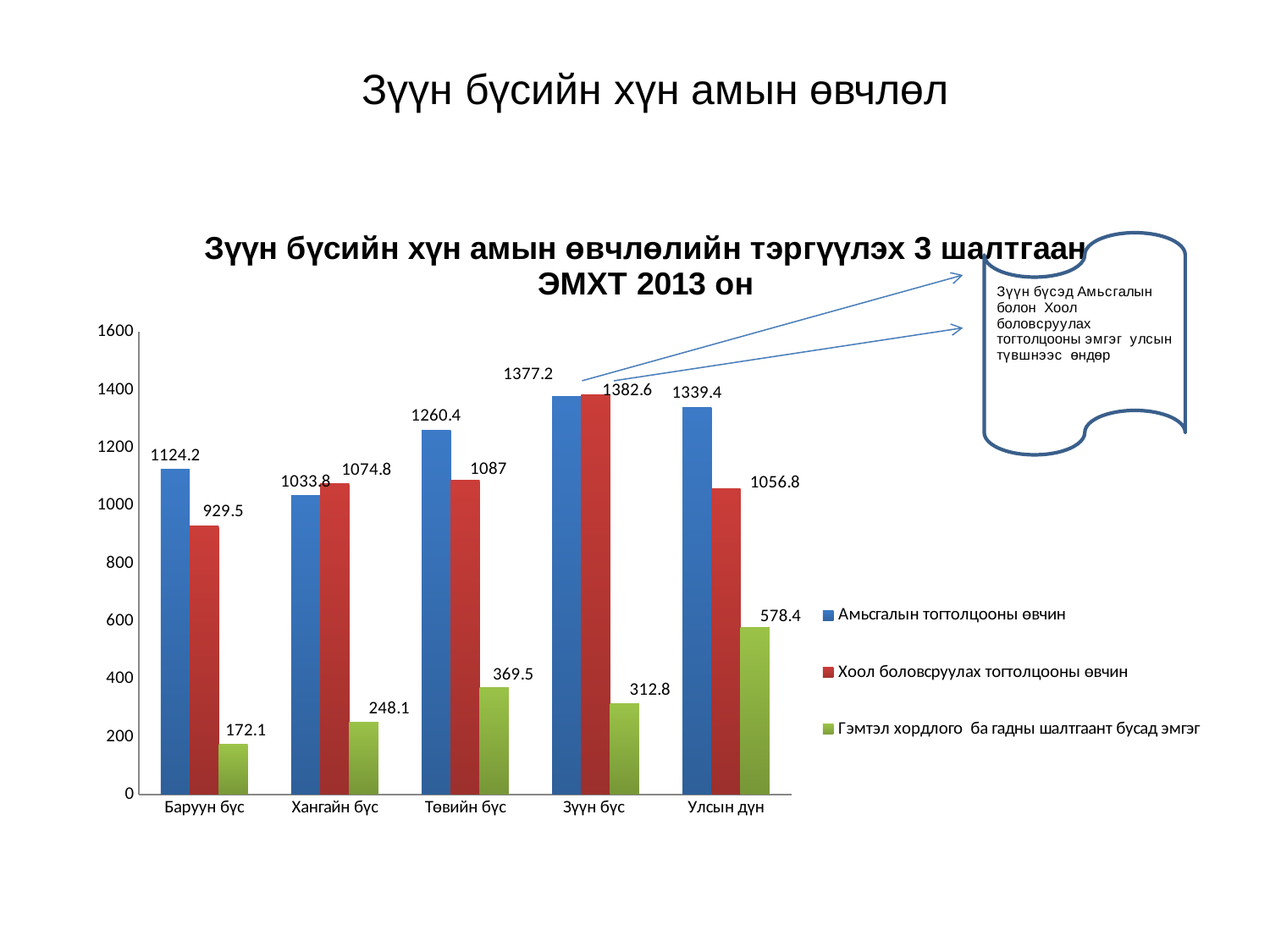
How many categories are shown on the x axis? 5 What is the value of Гэмтэл хордлого ба гадны шалтгаант бусад эмгэг for Улсын дүн? 578.4 Which is larger for Төвийн бүс: Амьсгалын тогтолцооны өвчин or Хоол боловсруулах тогтолцооны өвчин? Амьсгалын тогтолцооны өвчин How many series does the legend list? 3 What year is mentioned in the chart title? 2013 What type of chart is shown on the slide? Bar chart What is the difference between the Амьсгалын тогтолцооны өвчин values for Зүүн бүс and Улсын дүн? 37.8 Which category has the lowest value for Амьсгалын тогтолцооны өвчин? Хангайн бүс What is the value of Амьсгалын тогтолцооны өвчин for Зүүн бүс? 1377.2 Is the value of Гэмтэл хордлого ба гадны шалтгаант бусад эмгэг for Төвийн бүс greater or less than 400? less What is the value of Хоол боловсруулах тогтолцооны өвчин for Баруун бүс? 929.5 Which category has the highest value for Гэмтэл хордлого ба гадны шалтгаант бусад эмгэг? Улсын дүн